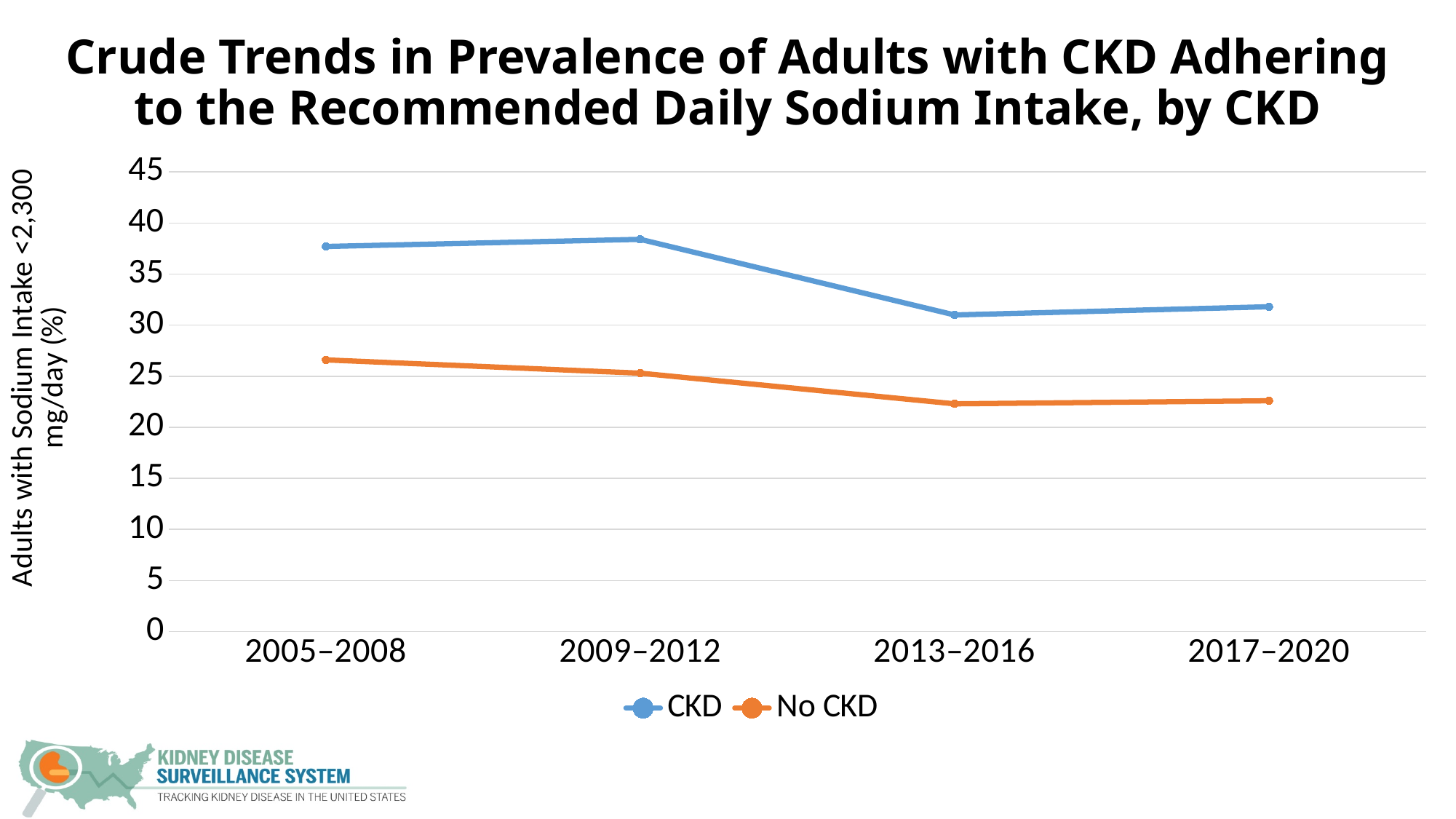
Which series has the higher value in 2005–2008, CKD or No CKD? CKD Is the value for CKD in 2005–2008 greater or less than 35? greater Is the value for No CKD in 2005–2008 greater or less than 25? greater Which series has the higher value in 2017–2020, CKD or No CKD? CKD Is the value for CKD in 2009–2012 greater or less than 40? less In which period is the No CKD series at its highest? 2005–2008 Does the No CKD series rise or fall from 2005–2008 to 2013–2016? Fall What kind of chart is shown on the slide? Line chart How many time periods are shown on the x axis? 4 What is the label of the y axis? Adults with Sodium Intake <2,300 mg/day (%) How many series does the legend list? 2